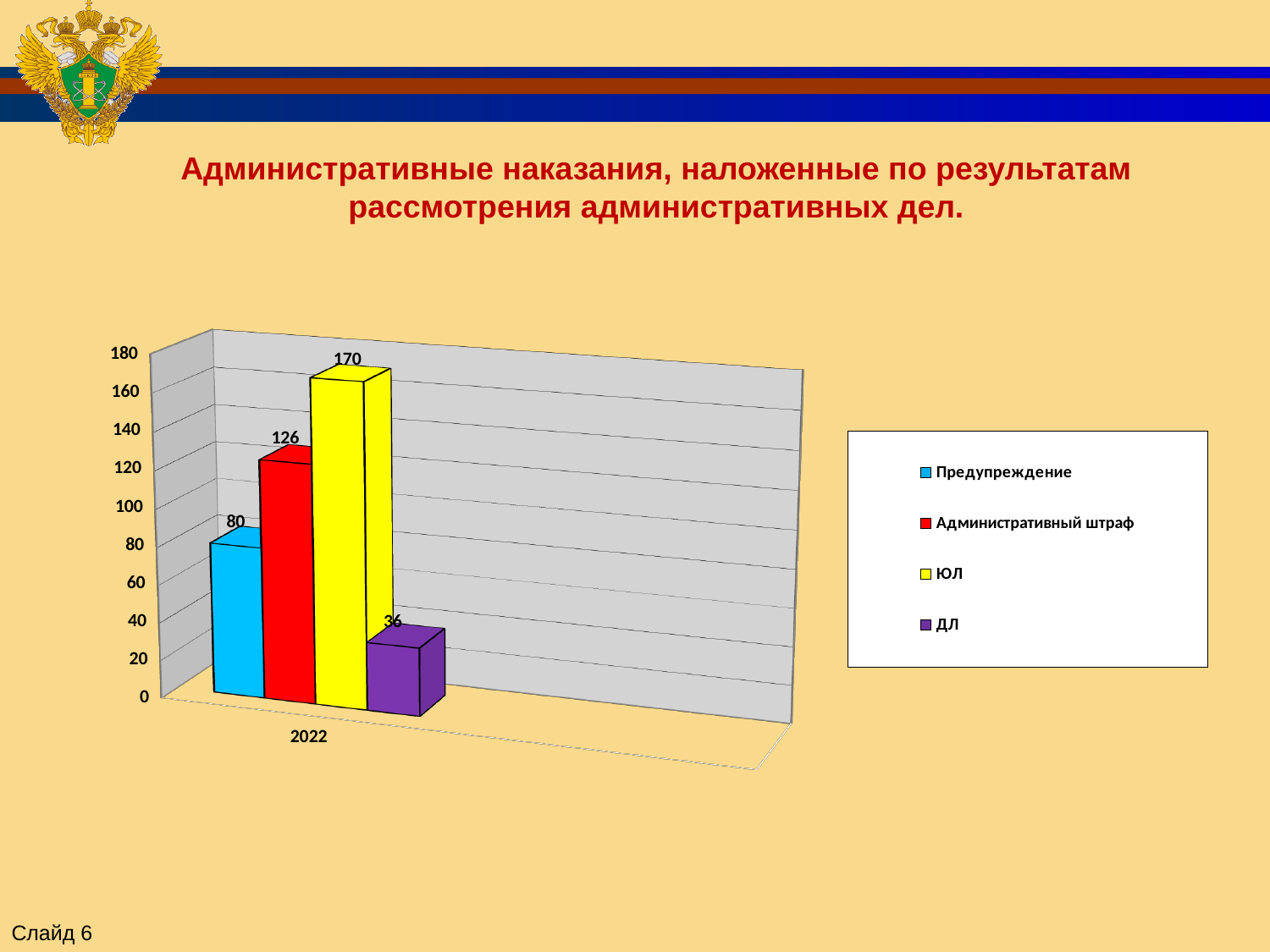
Which is larger, the value for Административный штраф or the value for Предупреждение? Административный штраф What is the value for Предупреждение in 2022? 80 Which series has the highest value in 2022? ЮЛ What is the difference between the values for Предупреждение and ДЛ? 44 Which series has the lowest value in 2022? ДЛ What is the value for Административный штраф in 2022? 126 What is the difference between the values for ЮЛ and Административный штраф? 44 What is the value for ДЛ in 2022? 36 What colour is the bar for ЮЛ? yellow How many series does the legend list? 4 What is the value for ЮЛ in 2022? 170 What kind of chart is shown on the slide? bar chart